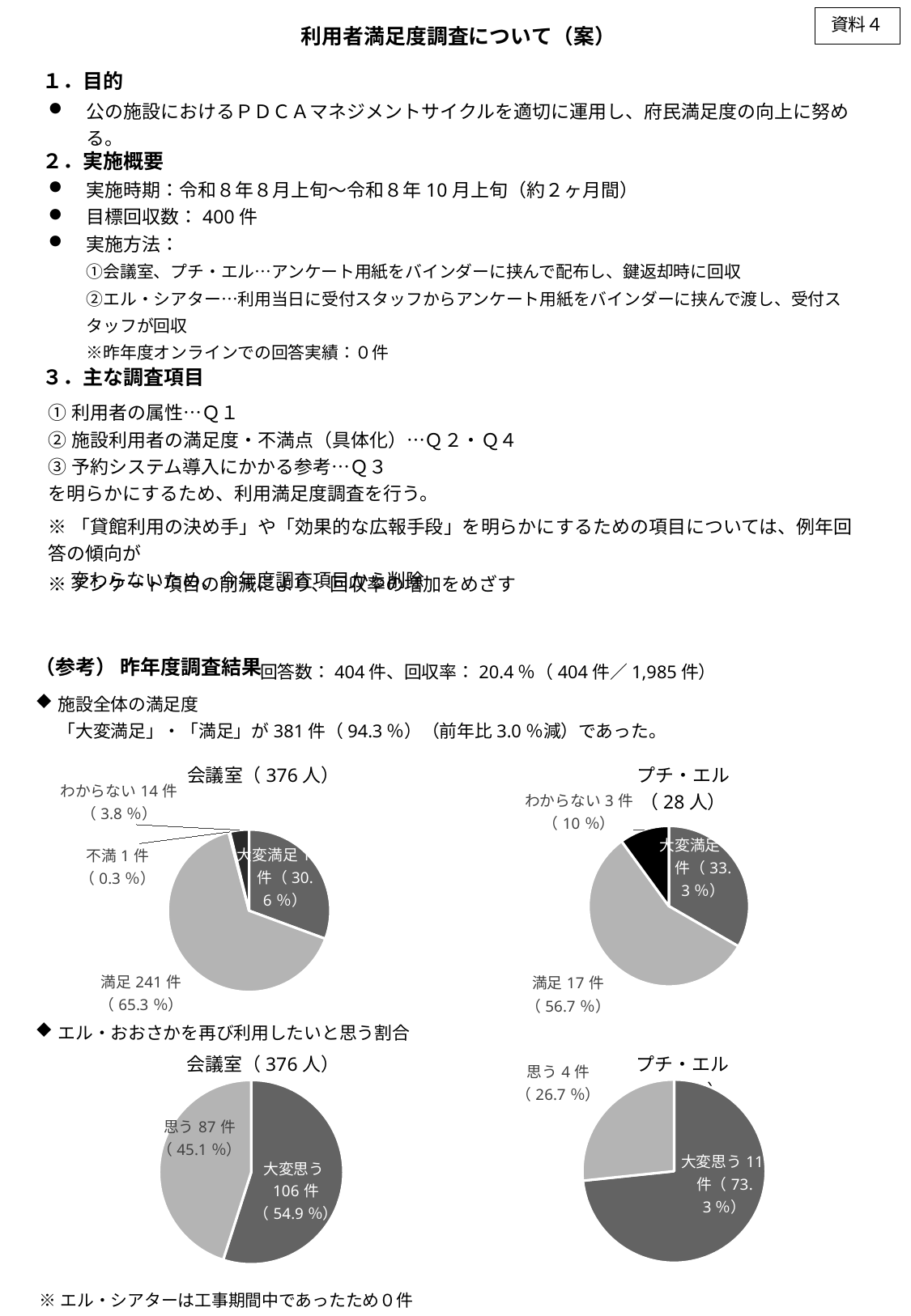
「施設全体の満足度」の会議室（376人）の円グラフで、最も件数が少ない項目はどれですか？ 不満 「施設全体の満足度」の会議室（376人）の円グラフで、最も割合が大きい項目はどれですか？ 満足 「エル・おおさかを再び利用したいと思う割合」のプチ・エルの円グラフで、「思う」と「大変思う」の件数の差はいくつですか？ 7件 「施設全体の満足度」のプチ・エルの円グラフで、「満足」は何件ですか？ 17件 「施設全体の満足度」のプチ・エルの円グラフで、「わからない」と「満足」の件数の差はいくつですか？ 14件 「施設全体の満足度」のプチ・エルの円グラフで、「大変満足」の割合は何％ですか？ 33.3％ 「エル・おおさかを再び利用したいと思う割合」の会議室（376人）のグラフはどの種類のグラフですか？ 円グラフ 「エル・おおさかを再び利用したいと思う割合」の会議室（376人）の円グラフで、「大変思う」は何件ですか？ 106件 「施設全体の満足度」の会議室（376人）の円グラフで、「わからない」の割合は何％ですか？ 3.8％ 「エル・おおさかを再び利用したいと思う割合」の会議室（376人）の円グラフで、「思う」と「大変思う」ではどちらが多いですか？ 大変思う 「エル・おおさかを再び利用したいと思う割合」のプチ・エルの円グラフで、「大変思う」の割合は何％ですか？ 73.3％ 「施設全体の満足度」の会議室（376人）の円グラフで、「満足」は何件ですか？ 241件